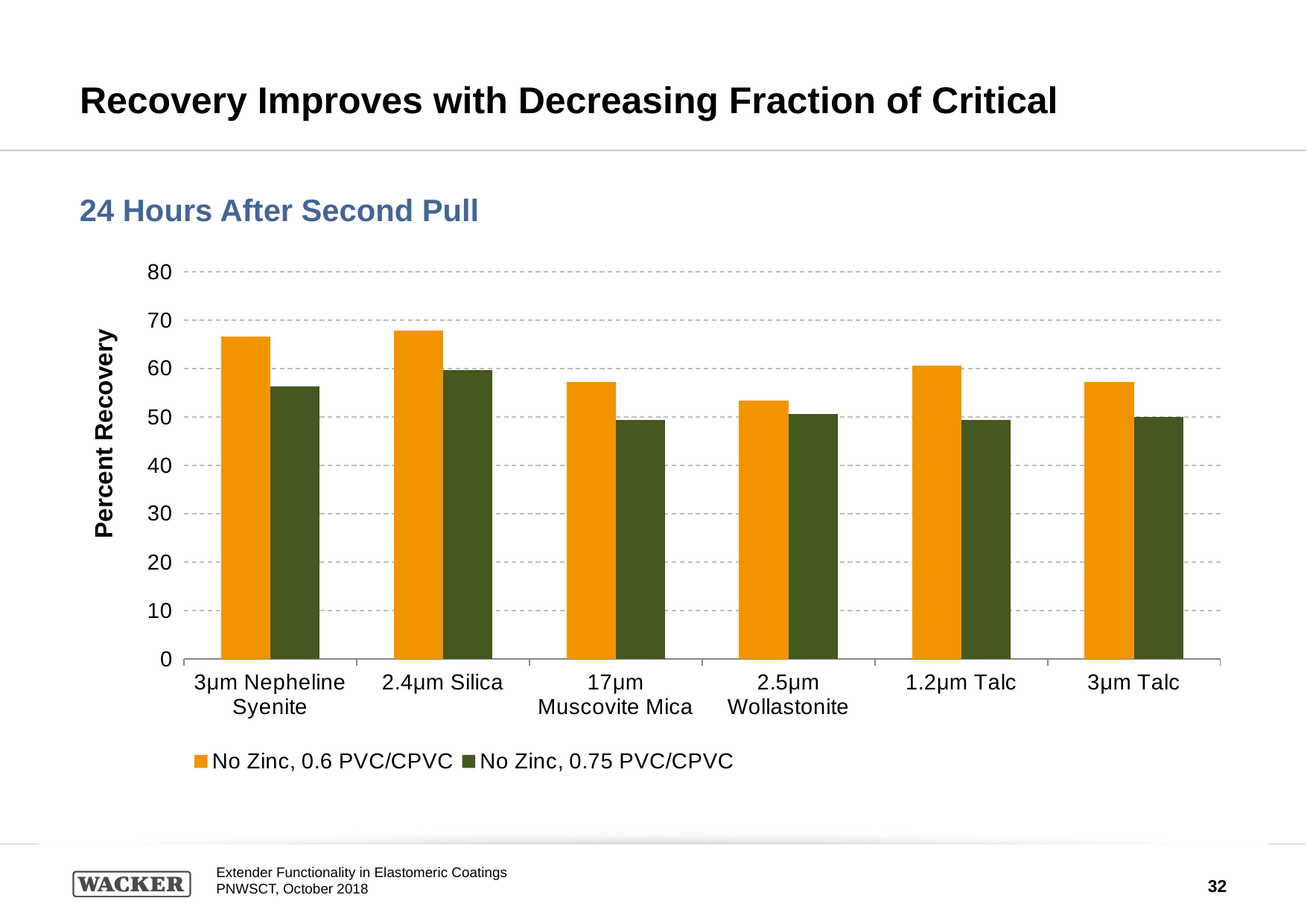
For 1.2µm Talc, which series has the larger value: No Zinc, 0.6 PVC/CPVC or No Zinc, 0.75 PVC/CPVC? No Zinc, 0.6 PVC/CPVC How many extender categories are shown on the x axis? 6 Is the value for 2.4µm Silica in the No Zinc, 0.6 PVC/CPVC series greater or less than 70? less Is the value for 3µm Nepheline Syenite in the No Zinc, 0.75 PVC/CPVC series greater or less than 50? greater What is the y-axis label of the chart? Percent Recovery How many series does the legend list? 2 Is the value for 3µm Talc in the No Zinc, 0.6 PVC/CPVC series greater or less than 60? less What kind of chart is shown on the slide? bar chart Which series is shown in orange? No Zinc, 0.6 PVC/CPVC Which category has the highest value in the No Zinc, 0.75 PVC/CPVC series? 2.4µm Silica Which category has the lowest value in the No Zinc, 0.6 PVC/CPVC series? 2.5µm Wollastonite